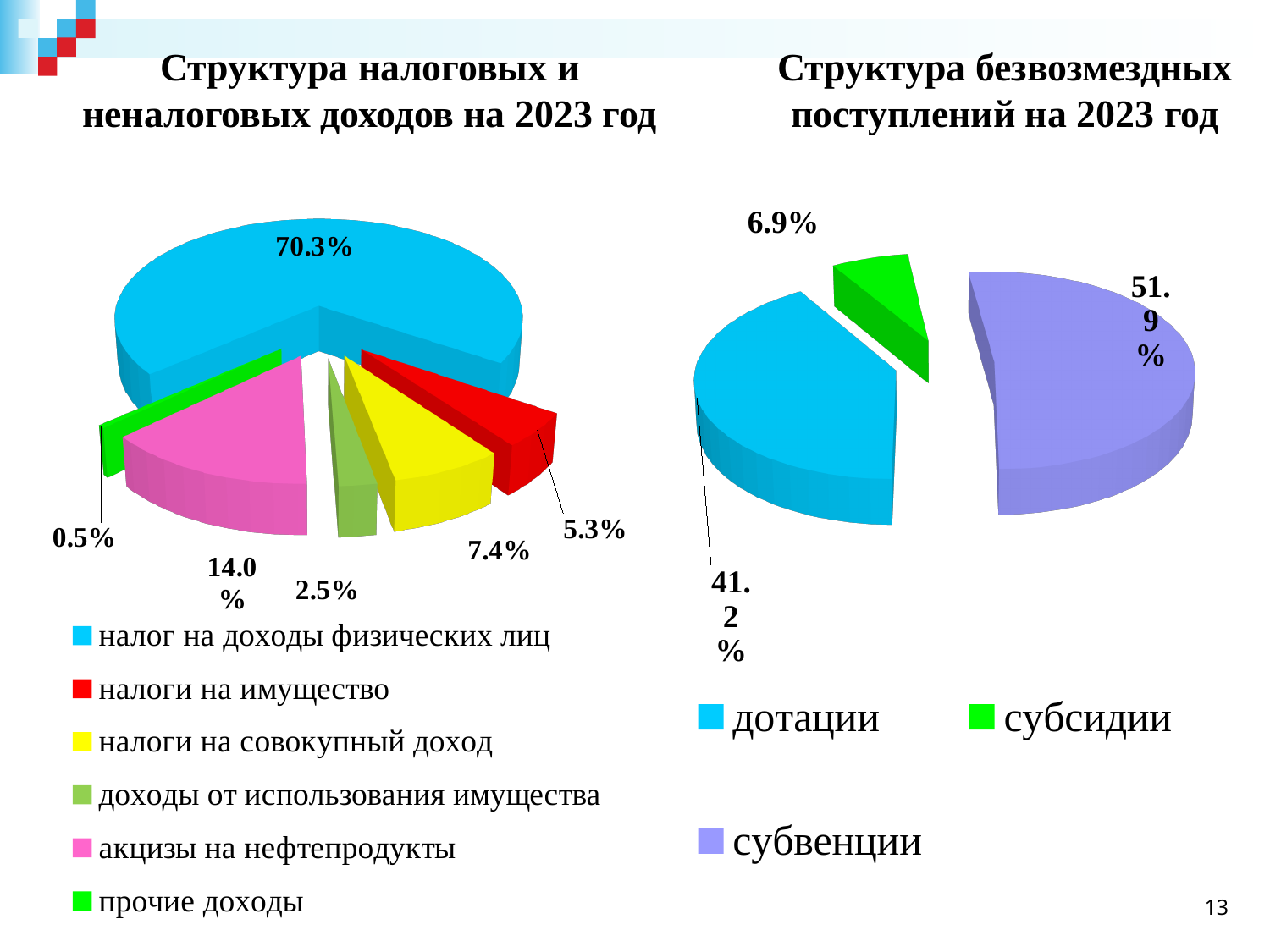
What type of chart is the chart titled «Структура безвозмездных поступлений на 2023 год»? pie chart In the chart titled «Структура налоговых и неналоговых доходов на 2023 год», which category has the smallest share? прочие доходы In the chart titled «Структура налоговых и неналоговых доходов на 2023 год», what share is shown for «налог на доходы физических лиц»? 70.3% In the chart titled «Структура налоговых и неналоговых доходов на 2023 год», what is the difference between the shares of «налоги на совокупный доход» and «налоги на имущество»? 2.1% In the chart titled «Структура безвозмездных поступлений на 2023 год», what share is shown for «дотации»? 41.2% In the chart titled «Структура налоговых и неналоговых доходов на 2023 год», what share is shown for «налоги на совокупный доход»? 7.4% In the chart titled «Структура безвозмездных поступлений на 2023 год», what is the difference between the shares of «субвенции» and «дотации»? 10.7% In the chart titled «Структура налоговых и неналоговых доходов на 2023 год», how many categories does the legend list? 6 In the chart titled «Структура безвозмездных поступлений на 2023 год», what share is shown for «субвенции»? 51.9% In the chart titled «Структура безвозмездных поступлений на 2023 год», which is larger, «дотации» or «субсидии»? дотации In the chart titled «Структура налоговых и неналоговых доходов на 2023 год», which category has the largest share? налог на доходы физических лиц In the chart titled «Структура налоговых и неналоговых доходов на 2023 год», what share is shown for «акцизы на нефтепродукты»? 14.0%